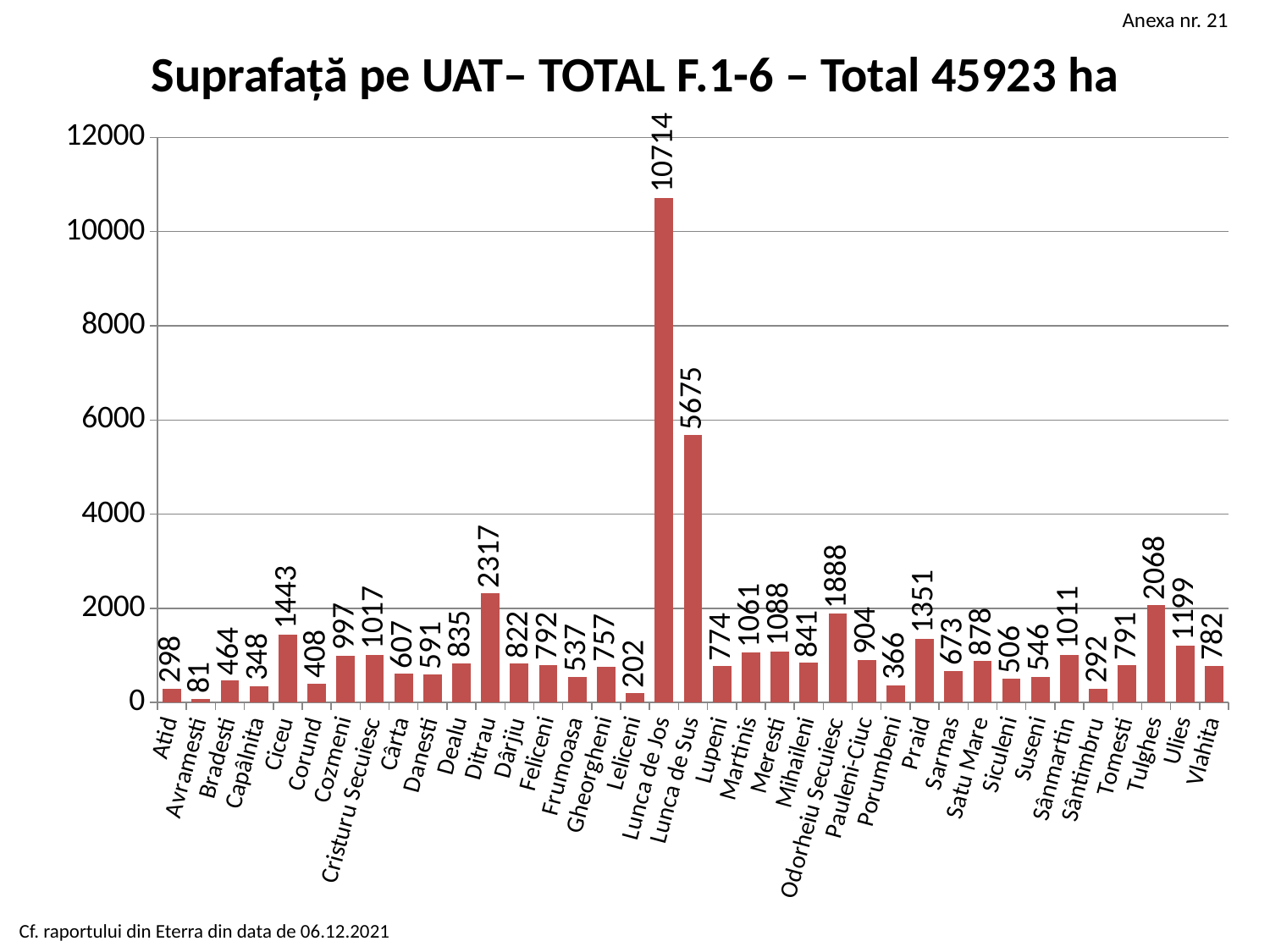
How many UATs are shown on the chart? 37 What is the title of the chart? Suprafață pe UAT– TOTAL F.1-6 – Total 45923 ha Which UAT has the highest value? Lunca de Jos Which UAT has the lowest value? Avramesti Is the value for Praid greater or less than 2000? less What is the value for Lunca de Jos? 10714 What is the value for Odorheiu Secuiesc? 1888 What kind of chart is shown on the slide? bar chart What is the difference between the values for Lunca de Jos and Lunca de Sus? 5039 Which is larger, the value for Tulghes or the value for Ciceu? Tulghes What is the value for Ditrau? 2317 What is the value for Leliceni? 202